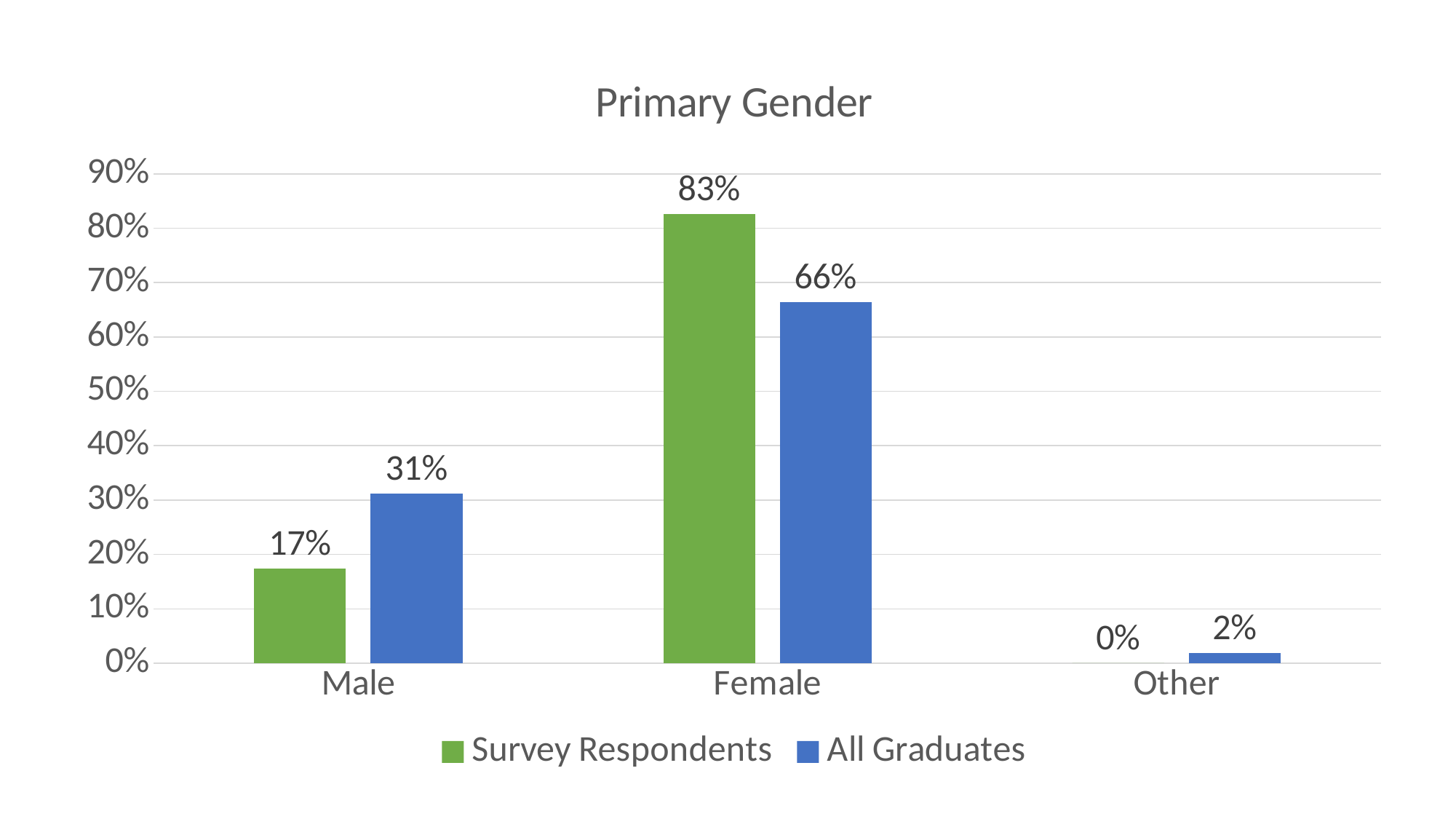
What is the Survey Respondents value for Other? 0% What is the difference between the Survey Respondents and All Graduates values for Female? 17% Which category has the highest Survey Respondents value? Female How many categories are shown on the x axis? 3 What type of chart is shown on the slide? Bar chart For Male, which series has the larger value: Survey Respondents or All Graduates? All Graduates Which category has the lowest All Graduates value? Other What is the difference between the All Graduates and Survey Respondents values for Male? 14% What is the All Graduates value for Female? 66% What is the Survey Respondents value for Female? 83% How many series does the legend list? 2 What is the All Graduates value for Male? 31%